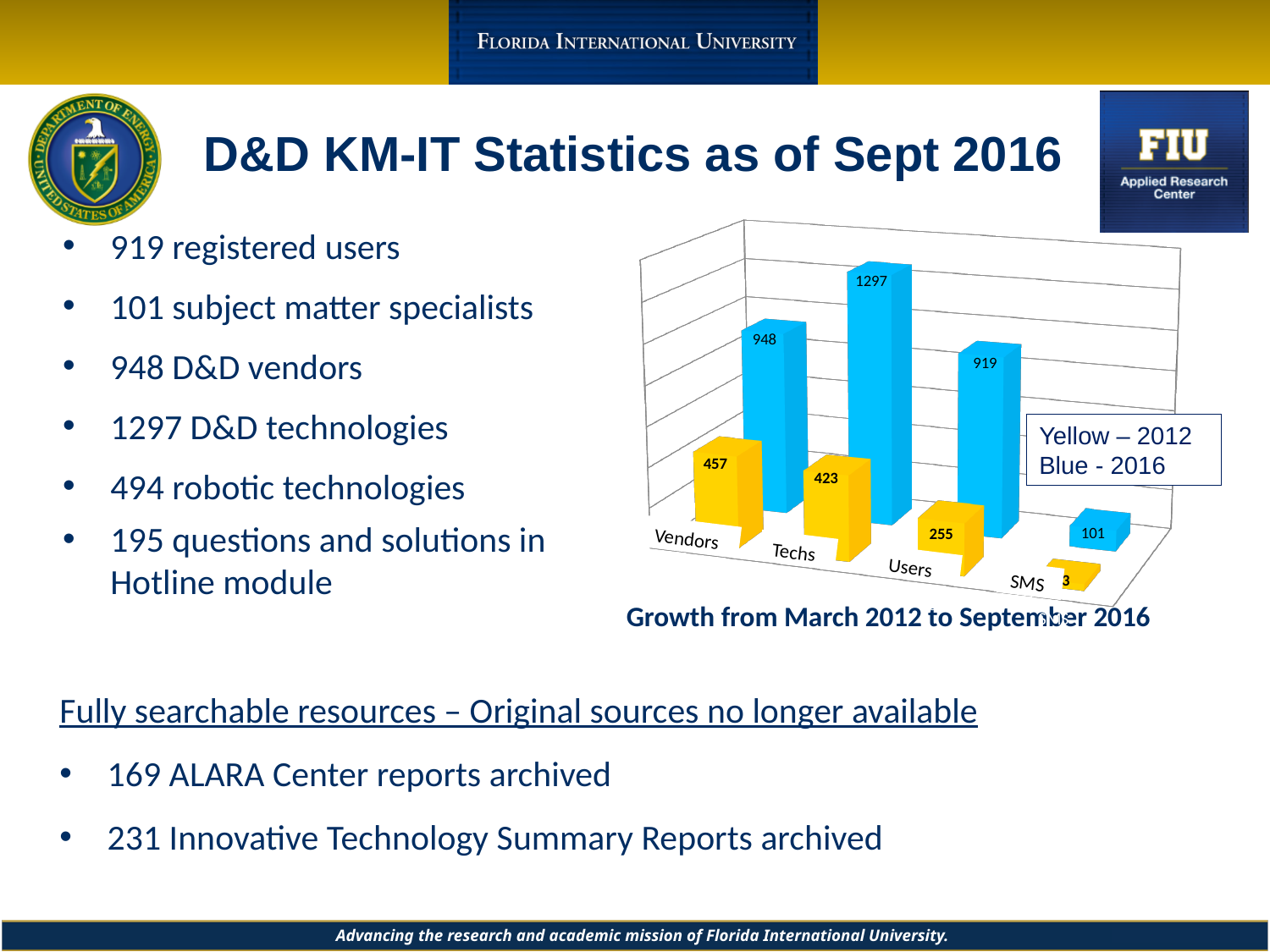
Which colour represents the 2012 values in the chart? Yellow Which category has the lowest 2012 (yellow) value? SMS How many categories are shown on the chart? 4 What type of chart is shown on the slide? bar chart What is the difference between the 2016 and 2012 values for Vendors? 491 Which is larger, the 2012 value for Techs or the 2012 value for Users? Techs What is the 2016 (blue) value for Techs? 1297 What is the 2012 (yellow) value for Vendors? 457 Which category has the highest 2016 (blue) value? Techs What is the 2016 (blue) value for Users? 919 How many series does the chart show? 2